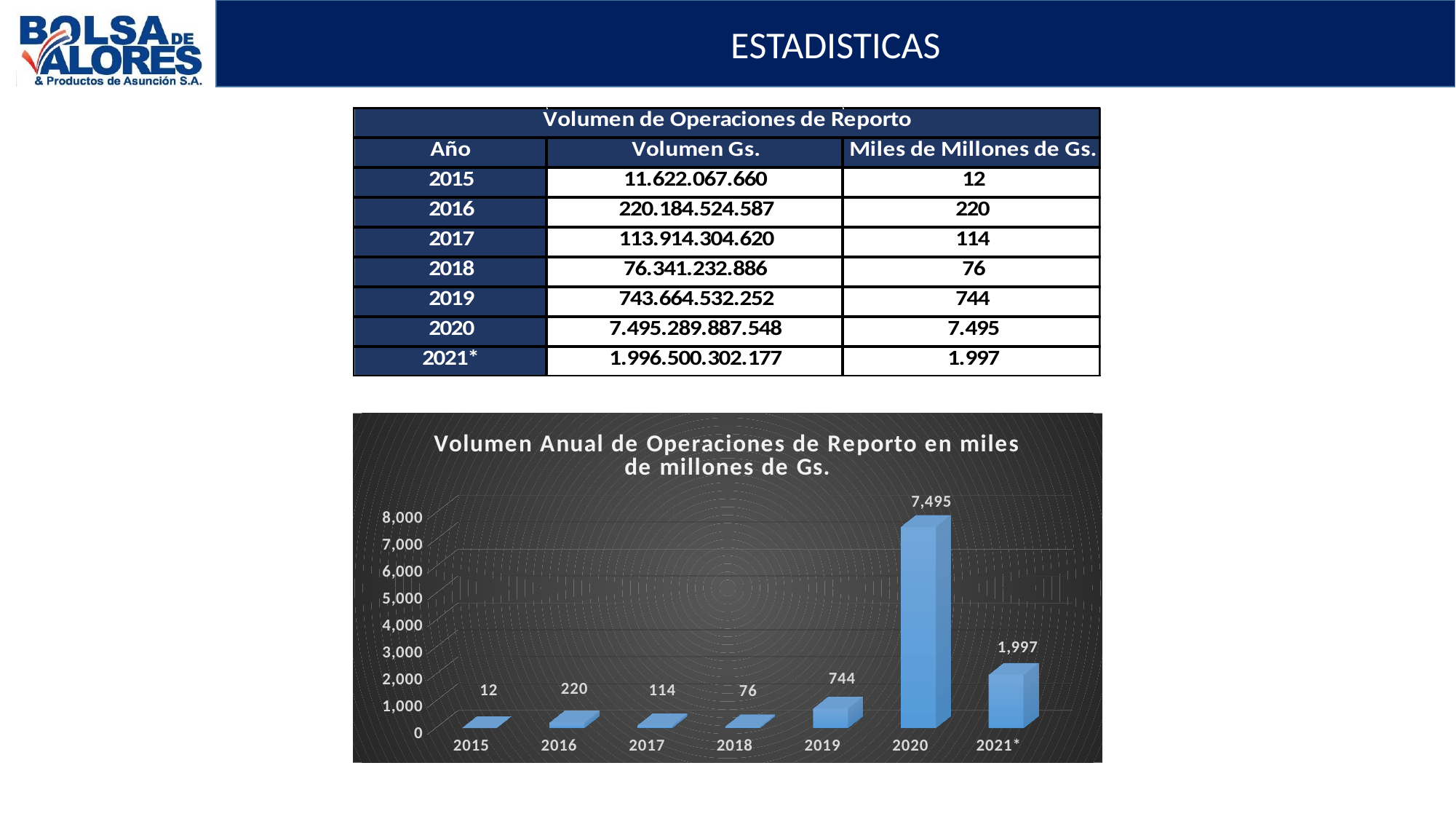
What is the difference between the values for 2020 and 2021* in the chart? 5,498 What is the difference between the values for 2016 and 2017 in the chart? 106 What is the value for 2019 in the chart? 744 Which is larger in the chart, the value for 2018 or the value for 2019? 2019 What is the title of the chart? Volumen Anual de Operaciones de Reporto en miles de millones de Gs. What is the value for 2021* in the chart? 1,997 Which year has the highest value in the chart? 2020 What is the value for 2016 in the chart? 220 What kind of chart is shown on the slide? bar chart How many years are shown on the x axis of the chart? 7 What is the value for 2020 in the chart? 7,495 Which year has the lowest value in the chart? 2015